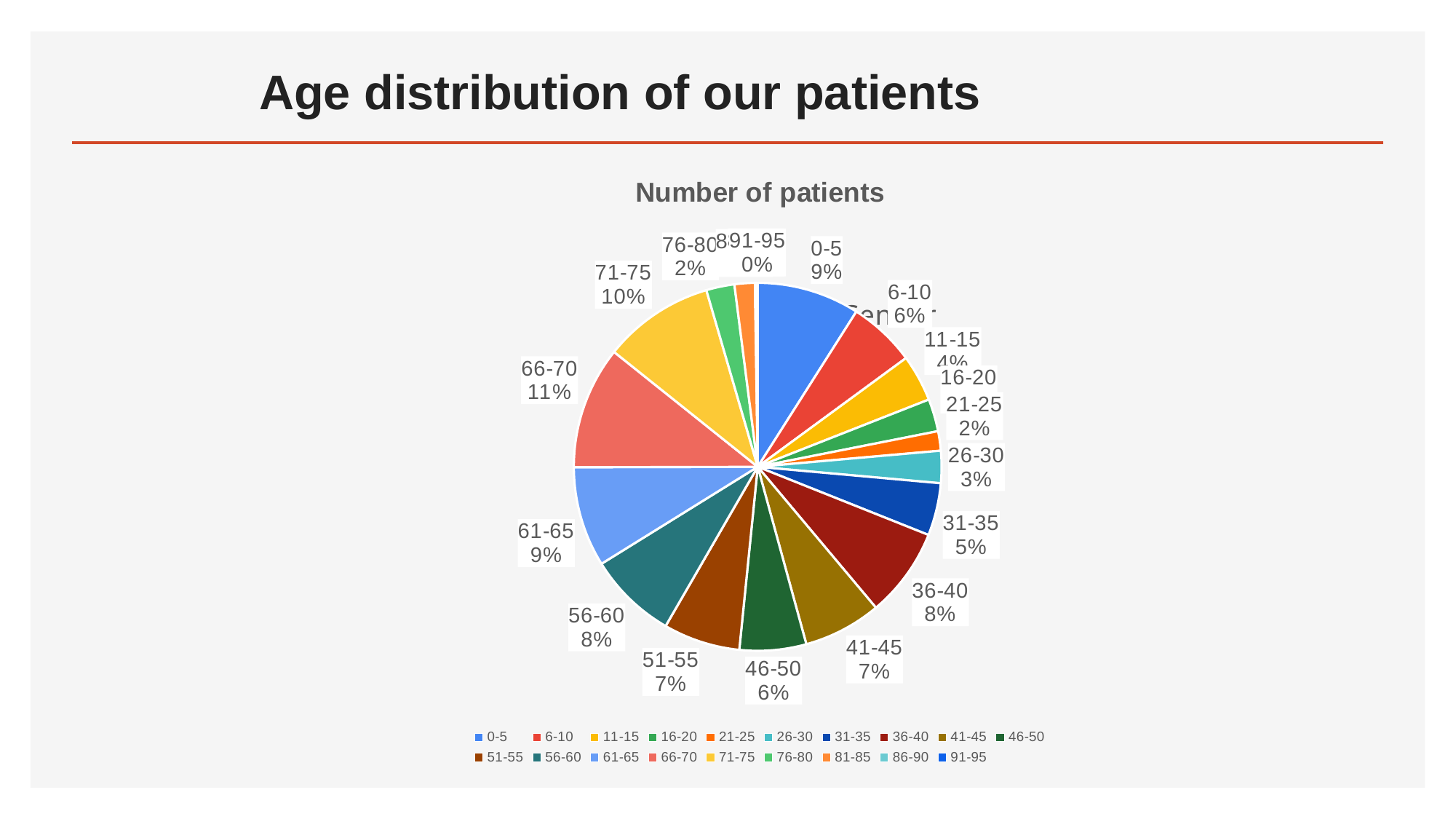
What share of patients is in the 36-40 age group? 8% What share of patients is in the 66-70 age group? 11% What is the difference in percentage points between the 66-70 and 26-30 age groups? 8 Which age group has the smallest share of patients? 91-95 Which age group has the largest share of patients? 66-70 What share of patients is in the 0-5 age group? 9% How many age groups does the legend list? 19 What type of chart is shown on the slide? pie chart What is the title of the chart? Number of patients Which age group has a larger share of patients, 61-65 or 21-25? 61-65